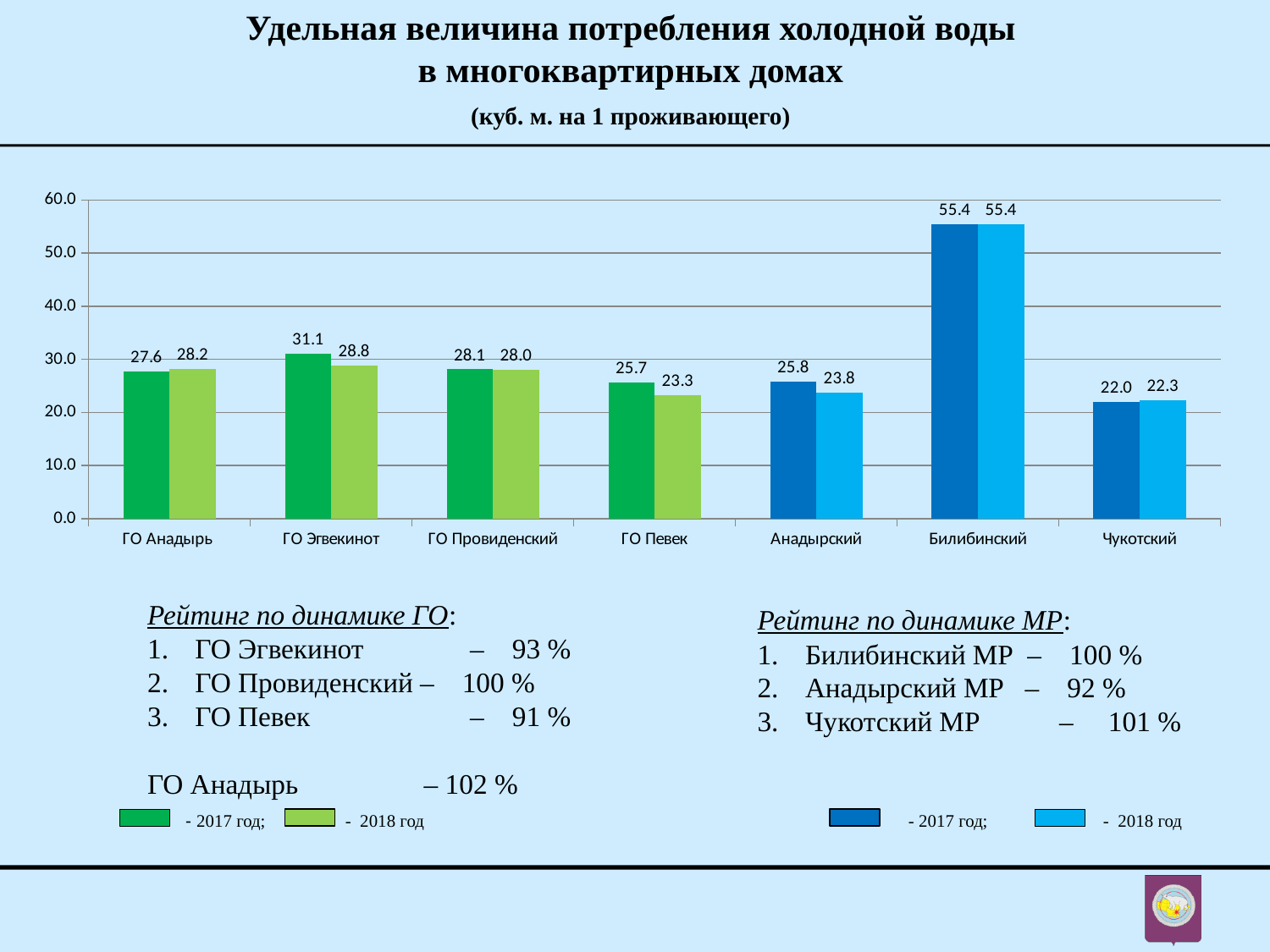
Is the 2018 value for Билибинский greater or less than 50.0? greater What is the difference between the 2017 and 2018 values for ГО Певек? 2.4 What unit is given in the chart's subtitle? куб. м. на 1 проживающего Which category has the highest value in 2017? Билибинский How many categories are shown on the x axis? 7 What is the 2017 value for Анадырский? 25.8 What is the difference between the 2017 value for Билибинский and the 2017 value for ГО Анадырь? 27.8 What type of chart is shown on the slide? bar chart Which category has the lowest value in 2018? Чукотский Which is larger: the 2017 value for ГО Эгвекинот or the 2017 value for ГО Провиденский? ГО Эгвекинот What is the 2018 value for Чукотский? 22.3 What is the 2018 value for ГО Эгвекинот? 28.8